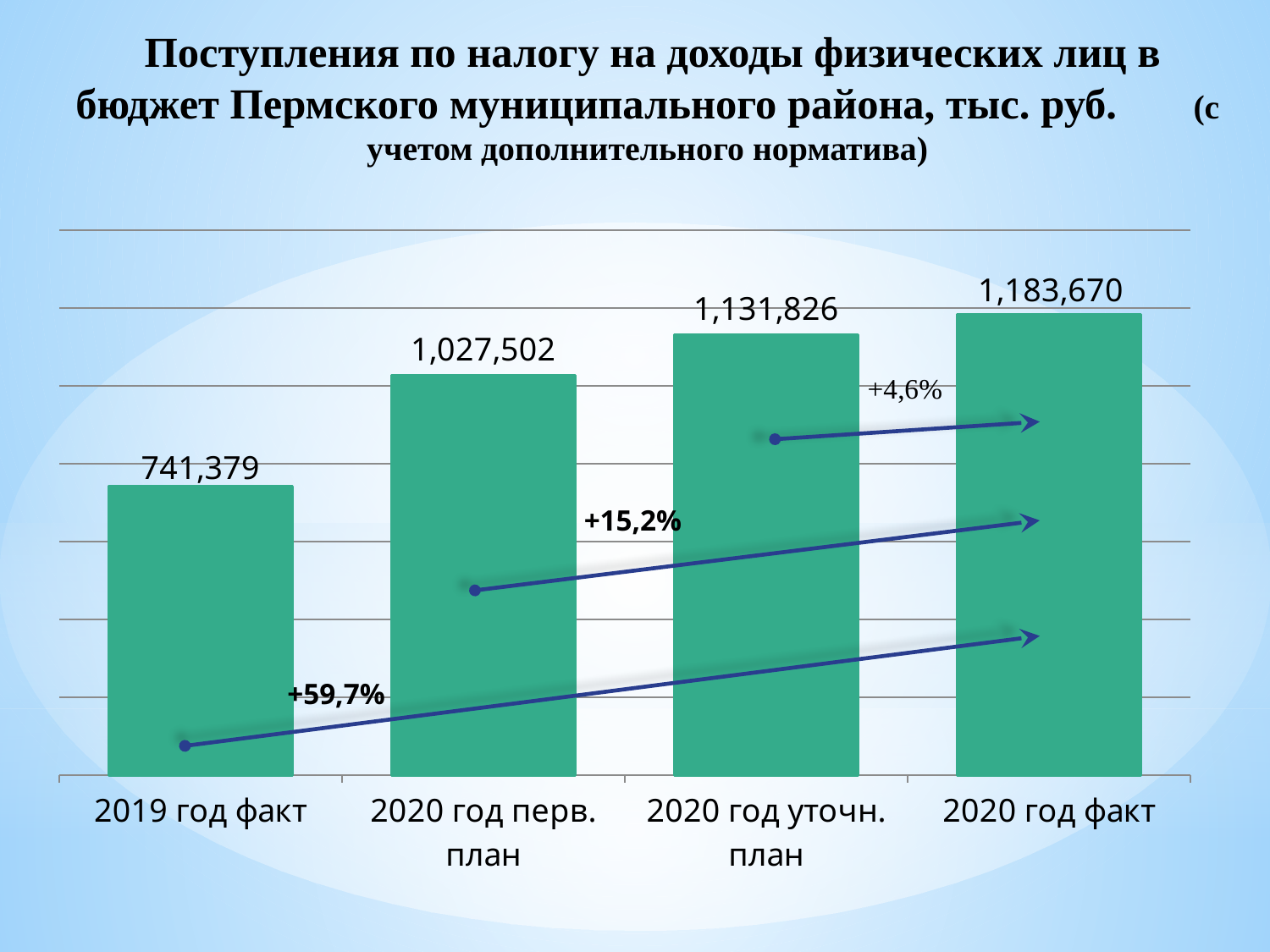
What kind of chart is shown on the slide? bar chart What is the value for 2020 год факт? 1,183,670 How many categories are shown on the x axis? 4 Do the values rise or fall from left to right along the x axis? rise What is the value for 2020 год уточн. план? 1,131,826 Which category has the lowest value? 2019 год факт What is the value for 2019 год факт? 741,379 Which is larger, the value for 2020 год перв. план or the value for 2020 год уточн. план? 2020 год уточн. план What is the difference between the values for 2020 год уточн. план and 2020 год перв. план? 104,324 What is the difference between the values for 2020 год факт and 2019 год факт? 442,291 Which category has the highest value? 2020 год факт What is the value for 2020 год перв. план? 1,027,502